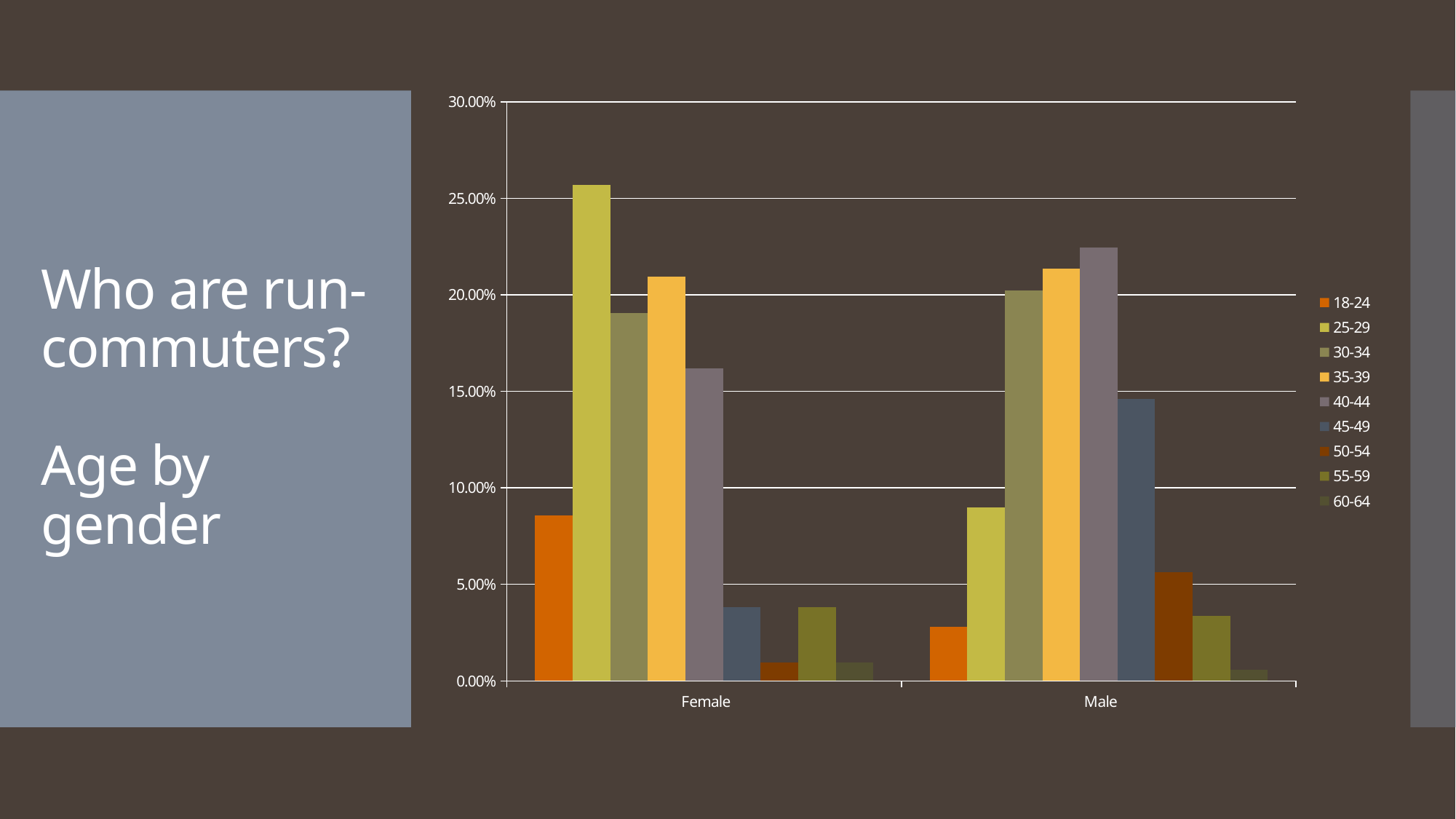
Is the value for 25-29 in the Female category greater or less than 25.00%? greater Which is larger for the 25-29 age group, the Female value or the Male value? Female Which age group has the highest value for Female? 25-29 What are the two categories labelled on the x axis? Female and Male What kind of chart is shown on the slide? bar chart Which age group has the highest value for Male? 40-44 Which is larger for the 45-49 age group, the Female value or the Male value? Male How many series does the legend list? 9 Which age group has the lowest value for Male? 60-64 Is the value for 45-49 in the Male category greater or less than 15.00%? less Is the value for 18-24 in the Male category greater or less than 5.00%? less How many categories are shown on the x axis? 2